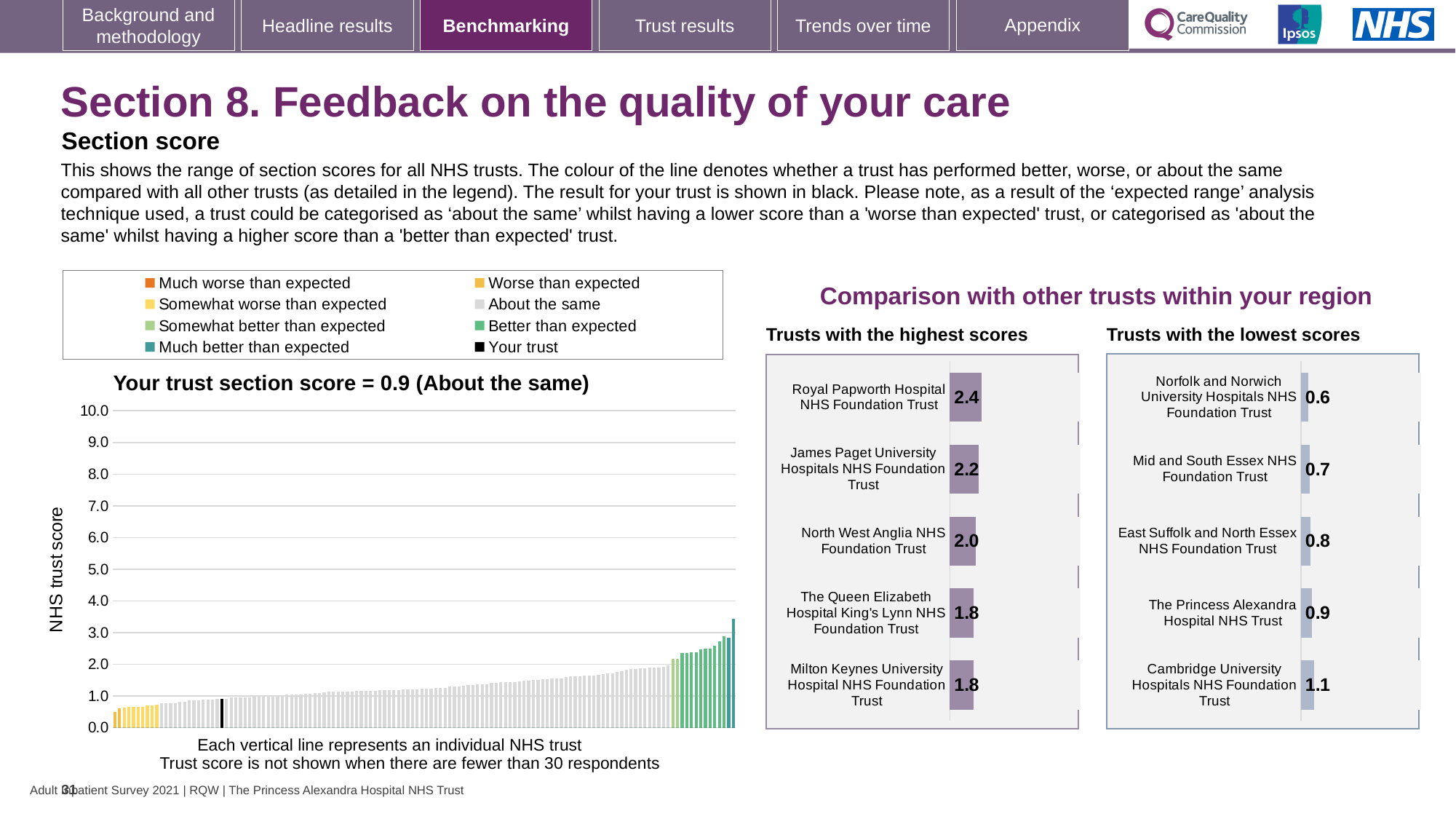
In the 'Trusts with the lowest scores' chart, what is the difference between the scores of Cambridge University Hospitals NHS Foundation Trust and Norfolk and Norwich University Hospitals NHS Foundation Trust? 0.5 In the 'Your trust section score' chart, do the trust scores rise or fall from left to right? Rise In the 'Trusts with the lowest scores' chart, which trust has the lowest score? Norfolk and Norwich University Hospitals NHS Foundation Trust What is the section score for your trust shown in the 'Your trust section score' chart? 0.9 In the 'Trusts with the highest scores' chart, what is the score for North West Anglia NHS Foundation Trust? 2.0 In the 'Trusts with the lowest scores' chart, what is the score for Mid and South Essex NHS Foundation Trust? 0.7 In the 'Trusts with the lowest scores' chart, which has the larger score: East Suffolk and North Essex NHS Foundation Trust or The Princess Alexandra Hospital NHS Trust? The Princess Alexandra Hospital NHS Trust How many trusts are shown in the 'Trusts with the highest scores' chart? 5 What type of chart is the 'Your trust section score' chart? Bar chart In the 'Trusts with the highest scores' chart, what is the difference between the scores of Royal Papworth Hospital NHS Foundation Trust and James Paget University Hospitals NHS Foundation Trust? 0.2 In the 'Trusts with the highest scores' chart, what is the score for Royal Papworth Hospital NHS Foundation Trust? 2.4 In the 'Trusts with the highest scores' chart, which trust has the highest score? Royal Papworth Hospital NHS Foundation Trust